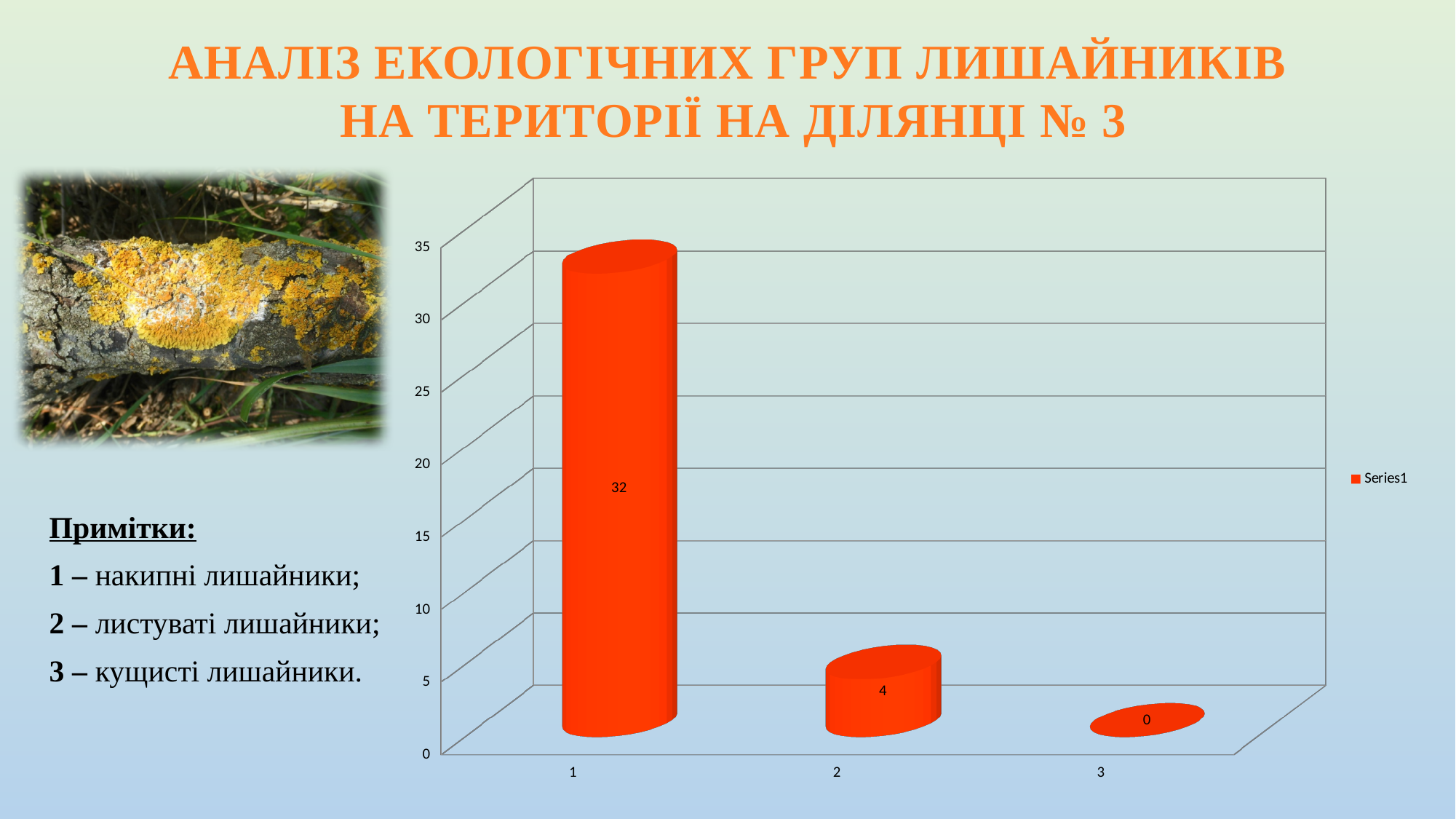
What is the value for category 3? 0 Which category has the highest value? 1 Which category has the lowest value? 3 What is the name of the series shown in the legend? Series1 What is the value for category 2? 4 What kind of chart is shown on the slide? bar chart What is the difference between the values for category 1 and category 2? 28 How many series does the legend list? 1 Which is larger, the value for category 2 or category 3? 2 What is the value for category 1? 32 Is the value for category 1 greater or less than 30? greater How many categories are shown on the x axis? 3